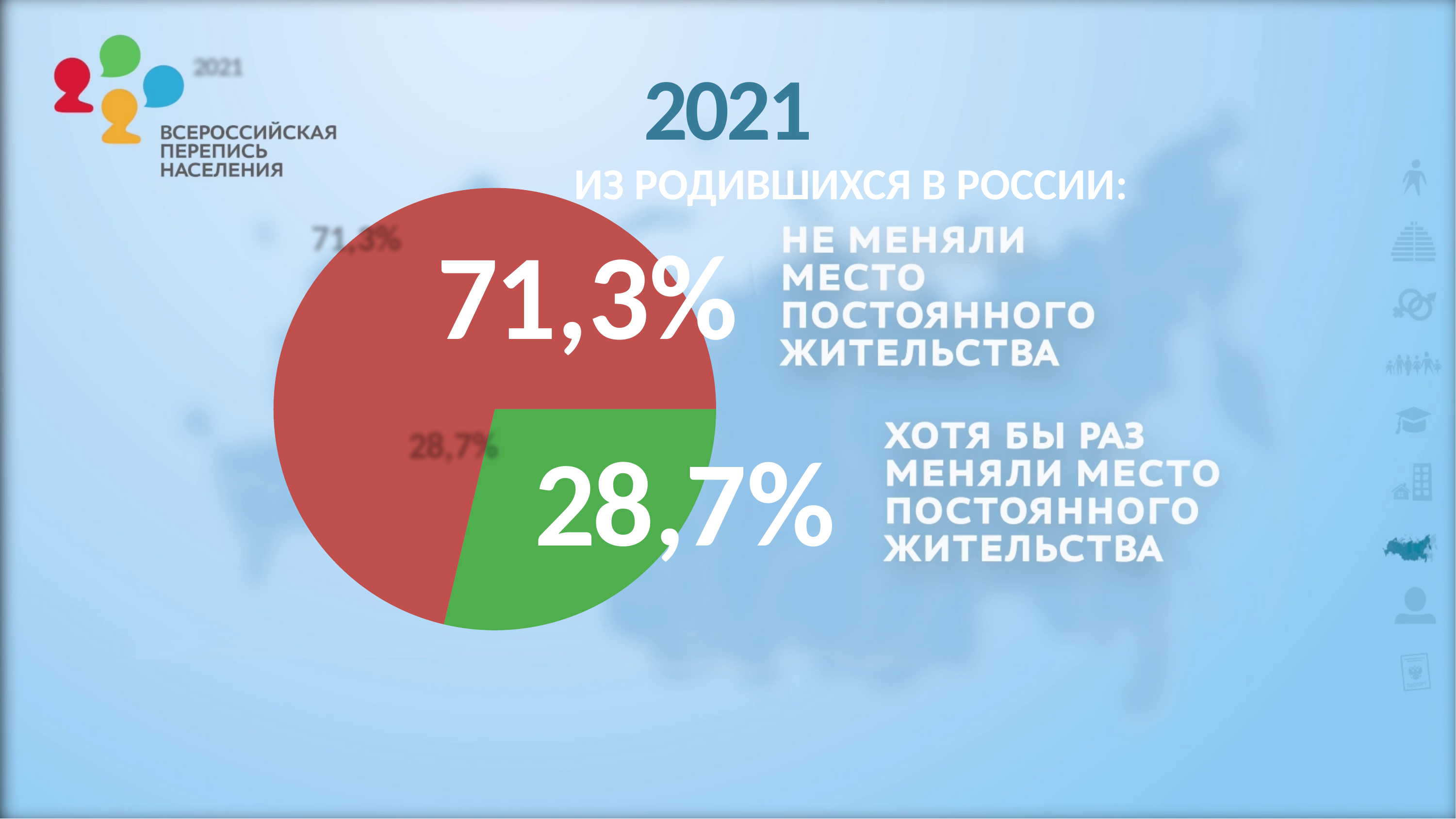
What kind of chart is shown on the slide? pie chart How many slices does the pie chart have? 2 What colour is the slice for those who did not change their place of permanent residence? red What share of those born in Russia changed their place of permanent residence at least once (ХОТЯ БЫ РАЗ МЕНЯЛИ МЕСТО ПОСТОЯННОГО ЖИТЕЛЬСТВА)? 28,7% Which is larger: the share that did not change residence or the share that changed it at least once? НЕ МЕНЯЛИ МЕСТО ПОСТОЯННОГО ЖИТЕЛЬСТВА Which category has the smallest slice of the pie? ХОТЯ БЫ РАЗ МЕНЯЛИ МЕСТО ПОСТОЯННОГО ЖИТЕЛЬСТВА What share of those born in Russia did not change their place of permanent residence (НЕ МЕНЯЛИ МЕСТО ПОСТОЯННОГО ЖИТЕЛЬСТВА)? 71,3% What colour is the slice for those who changed their place of permanent residence at least once? green What is the difference in percentage points between the share that did not change residence and the share that changed it at least once? 42,6 What year is shown above the chart? 2021 Which category has the largest slice of the pie? НЕ МЕНЯЛИ МЕСТО ПОСТОЯННОГО ЖИТЕЛЬСТВА